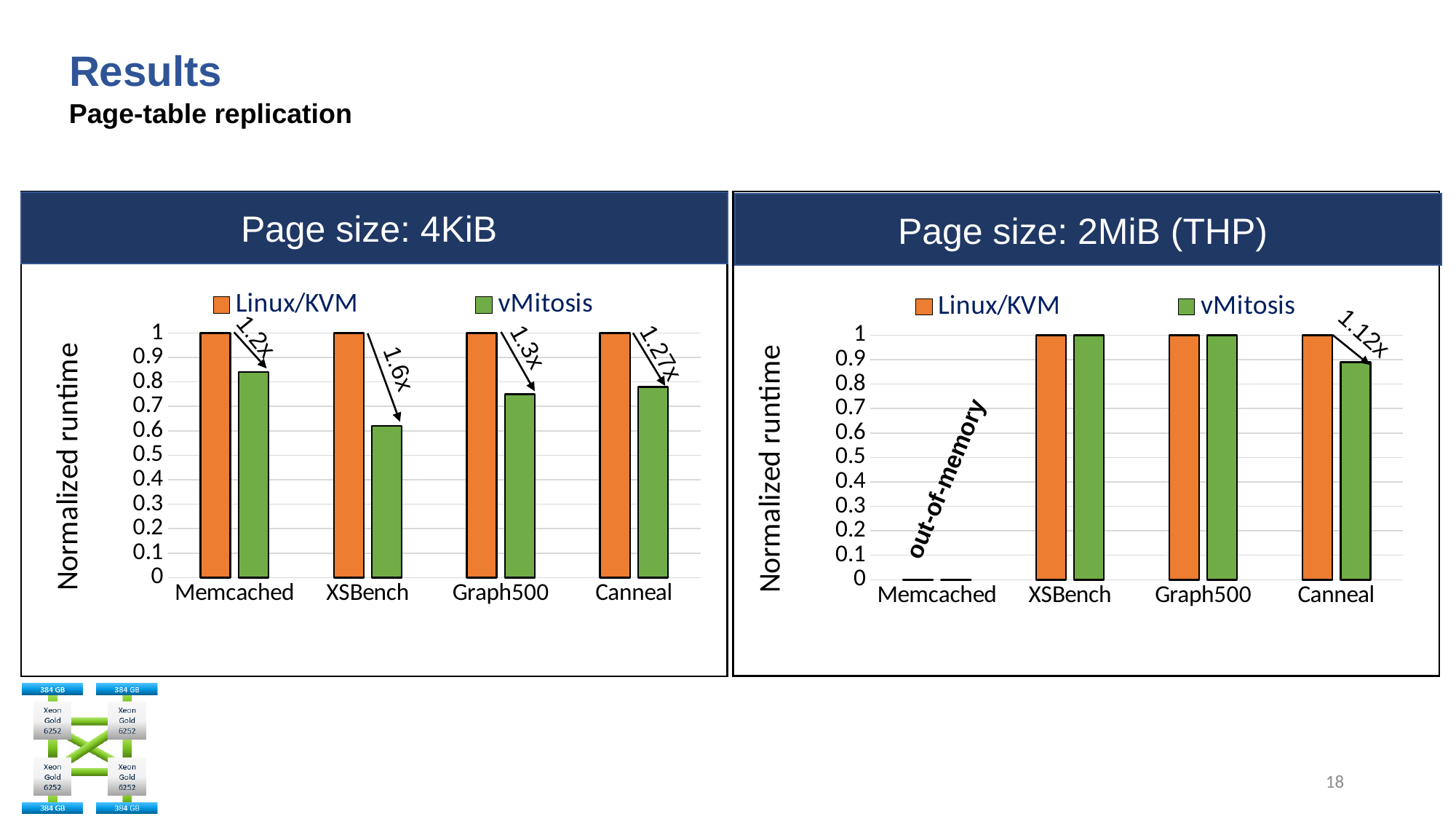
What kind of chart is the "Page size: 4KiB" chart? bar chart In the "Page size: 2MiB (THP)" chart, is the vMitosis value for Canneal greater or less than 0.8? greater In the "Page size: 2MiB (THP)" chart, what label is shown in place of the Memcached bars? out-of-memory In the "Page size: 4KiB" chart, which is larger for Graph500: the Linux/KVM bar or the vMitosis bar? Linux/KVM How many series does the legend of the "Page size: 4KiB" chart list? 2 In the "Page size: 4KiB" chart, is the vMitosis value for Memcached greater or less than 0.8? greater In the "Page size: 4KiB" chart, which category has the lowest vMitosis bar? XSBench In the "Page size: 4KiB" chart, is the vMitosis value for XSBench greater or less than 0.7? less In the "Page size: 4KiB" chart, what is the normalized runtime for Linux/KVM on Memcached? 1 How many categories are shown on the x axis of the "Page size: 2MiB (THP)" chart? 4 In the "Page size: 4KiB" chart, what speedup is annotated for XSBench? 1.6x In the "Page size: 2MiB (THP)" chart, what is the normalized runtime for vMitosis on XSBench? 1